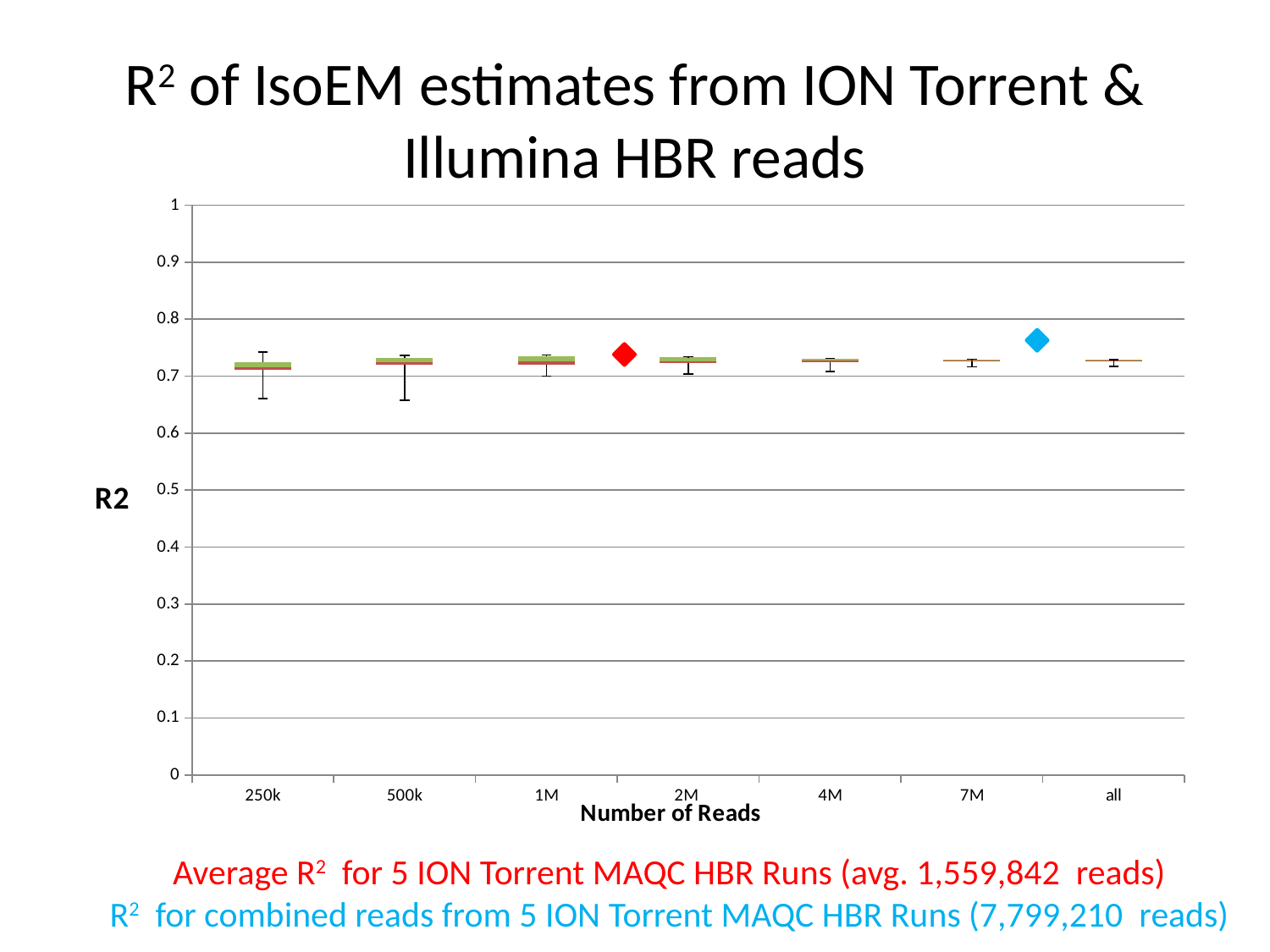
Is the R2 value marked by the blue diamond greater or less than 0.7? greater Which x-axis category is the first (leftmost) on the chart? 250k Is the median R2 value for 'all' reads greater or less than 0.6? greater Is the R2 value marked by the blue diamond greater or less than 0.8? less How many categories are shown on the x axis of the chart? 7 What kind of chart is shown on the slide? Box plot (box-and-whisker chart) What is the title of the chart on the slide? R2 of IsoEM estimates from ION Torrent & Illumina HBR reads What is the label of the x axis of the chart? Number of Reads